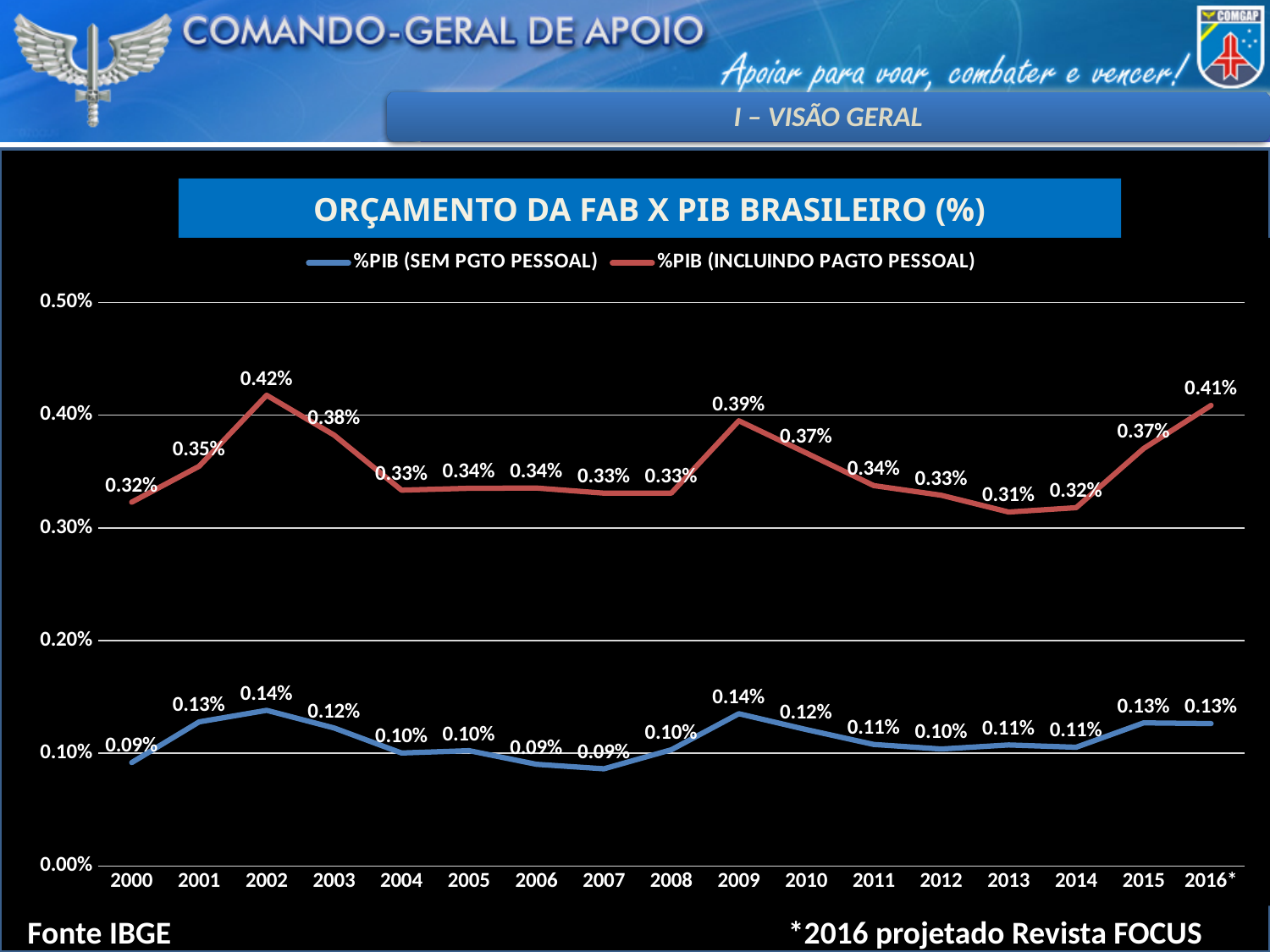
In which year is %PIB (INCLUINDO PAGTO PESSOAL) highest? 2002 Does %PIB (INCLUINDO PAGTO PESSOAL) rise or fall from 2013 to 2016*? Rise How many series does the legend list? 2 How many years are plotted along the x axis? 17 What is the difference between %PIB (INCLUINDO PAGTO PESSOAL) and %PIB (SEM PGTO PESSOAL) in 2000? 0.23% Which is larger: %PIB (INCLUINDO PAGTO PESSOAL) in 2009 or in 2010? 2009 What is the value of %PIB (SEM PGTO PESSOAL) in 2009? 0.14% What is the title of the chart? ORÇAMENTO DA FAB X PIB BRASILEIRO (%) What is the projected value of %PIB (INCLUINDO PAGTO PESSOAL) for 2016*? 0.41% What is the value of %PIB (INCLUINDO PAGTO PESSOAL) in 2002? 0.42% What type of chart is shown on the slide? Line chart In which year is %PIB (INCLUINDO PAGTO PESSOAL) lowest? 2013